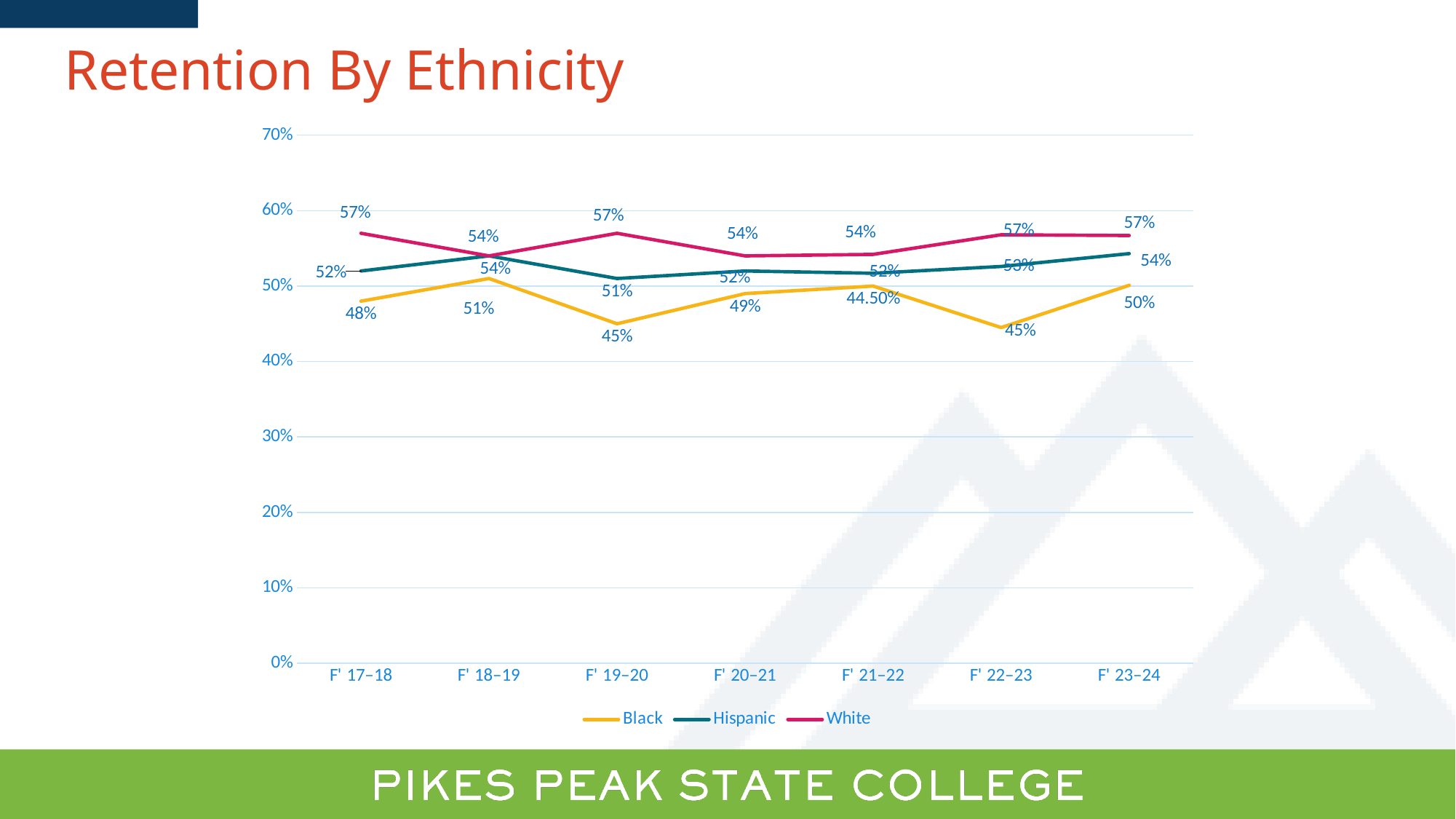
What is the difference between the White and Black retention rates in F' 19–20? 12 percentage points What is the retention rate for White students in F' 17–18? 57% What type of chart is shown on the slide? Line chart What is the retention rate for Black students in F' 19–20? 45% What is the title of the chart? Retention By Ethnicity Is the Hispanic retention rate higher in F' 18–19 or in F' 19–20? F' 18–19 Is the Black retention rate in F' 22–23 greater or less than 50%? less How many fall terms are plotted along the x axis? 7 What is the retention rate for Hispanic students in F' 19–20? 51% How many series does the legend list? 3 Does the Black retention rate rise or fall from F' 22–23 to F' 23–24? rise Which ethnicity has the highest retention rate in F' 19–20? White